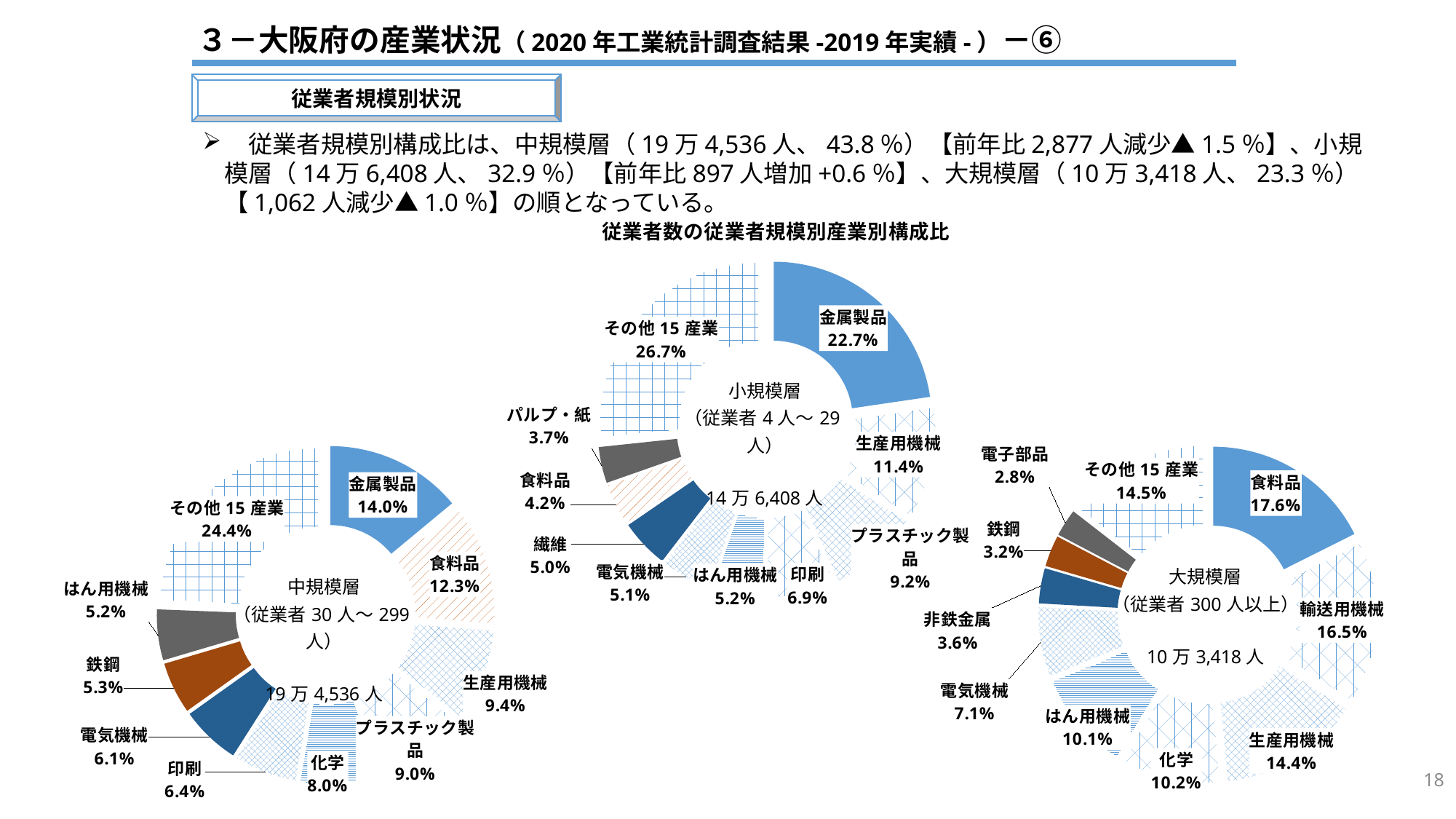
What type of chart is used to show the 大規模層 composition? Donut (pie) chart In the 大規模層 chart, which is larger: the share of 化学 or the share of 電気機械? 化学 In the 小規模層 chart, what is the share of 生産用機械? 11.4% In the 大規模層 chart, what is the share of 輸送用機械? 16.5% What is the title shown above the three charts? 従業者数の従業者規模別産業別構成比 What is the total number of employees shown in the centre of the 中規模層 chart? 19万4,536人 In the 小規模層 chart, which industry has the smallest share? パルプ・紙 In the 中規模層 chart, what is the difference between the shares of 金属製品 and 食料品? 1.7% In the 中規模層 chart, what is the share of 金属製品? 14.0% How many slices does the 小規模層 chart have? 10 In the 小規模層 chart, what is the share of その他15産業? 26.7% In the 大規模層 chart, which named industry (excluding その他15産業) has the largest share? 食料品